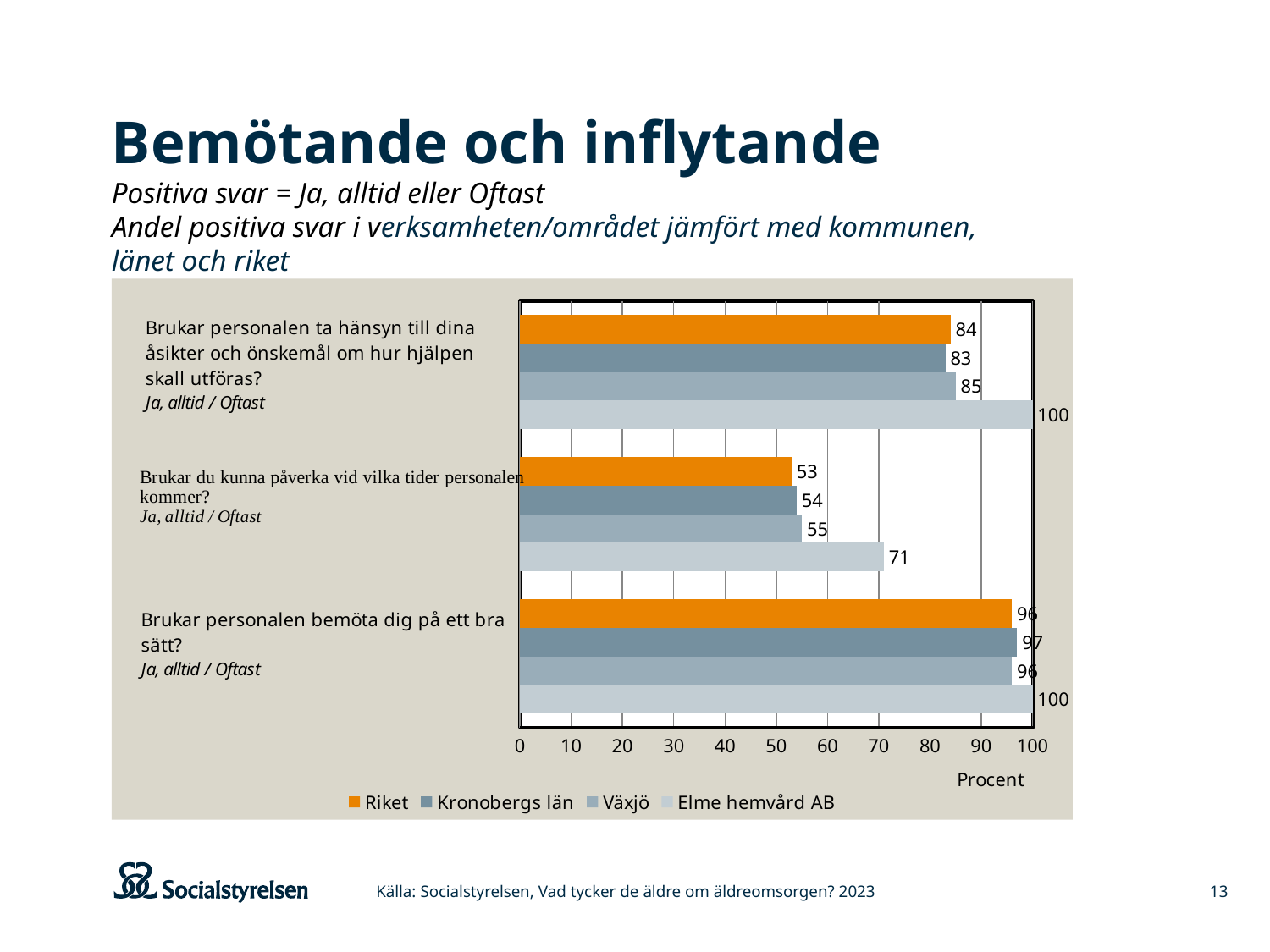
Which series has the highest value on the question "Brukar du kunna påverka vid vilka tider personalen kommer?"? Elme hemvård AB What is the value for Riket on the question "Brukar personalen ta hänsyn till dina åsikter och önskemål om hur hjälpen skall utföras?"? 84 What is the value for Kronobergs län on the question "Brukar personalen bemöta dig på ett bra sätt?"? 97 What is the value for Växjö on the question "Brukar du kunna påverka vid vilka tider personalen kommer?"? 55 What is the value for Elme hemvård AB on the question "Brukar du kunna påverka vid vilka tider personalen kommer?"? 71 What type of chart is shown on the slide? bar chart How many series does the legend list? 4 What label is shown on the horizontal axis of the chart? Procent What is the difference between Elme hemvård AB and Riket on the question "Brukar du kunna påverka vid vilka tider personalen kommer?"? 18 Which is larger on the question "Brukar personalen ta hänsyn till dina åsikter och önskemål om hur hjälpen skall utföras?": Växjö or Elme hemvård AB? Elme hemvård AB How many question categories are plotted on the chart? 3 Which series has the lowest value on the question "Brukar personalen ta hänsyn till dina åsikter och önskemål om hur hjälpen skall utföras?"? Kronobergs län